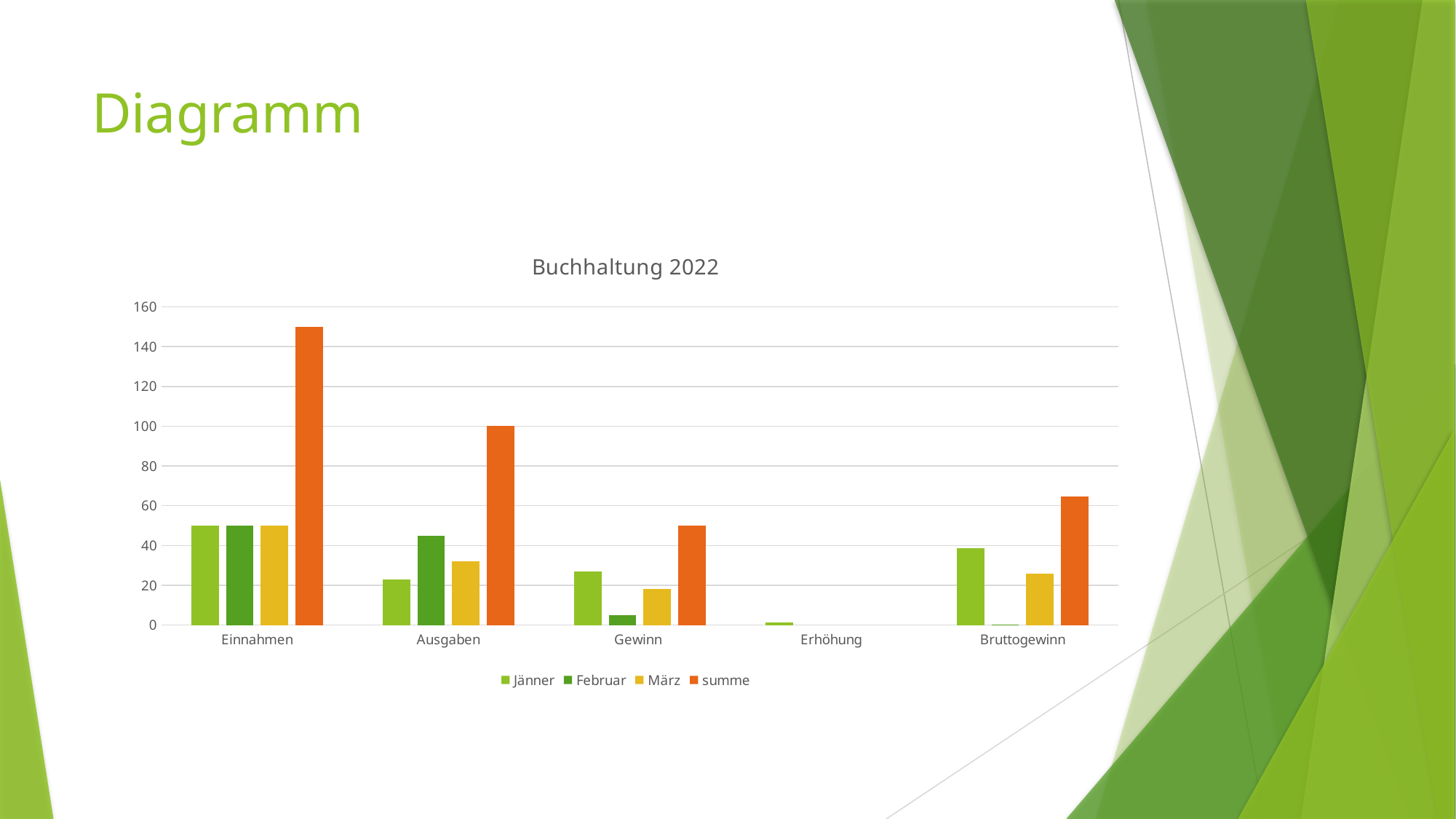
Which is larger, the Jänner value for Gewinn or the Februar value for Gewinn? Jänner Which category has the highest summe value? Einnahmen Is the summe value for Bruttogewinn greater or less than 60? greater Which category has the lowest Jänner value? Erhöhung Which series is shown in orange in the legend? summe What kind of chart is shown on the slide? bar chart How many categories are shown on the x axis? 5 What is the title of the chart? Buchhaltung 2022 How many series does the legend list? 4 Is the Februar value for Ausgaben greater or less than 40? greater What is the summe value for Ausgaben? 100 Is the summe value for Einnahmen greater or less than 140? greater